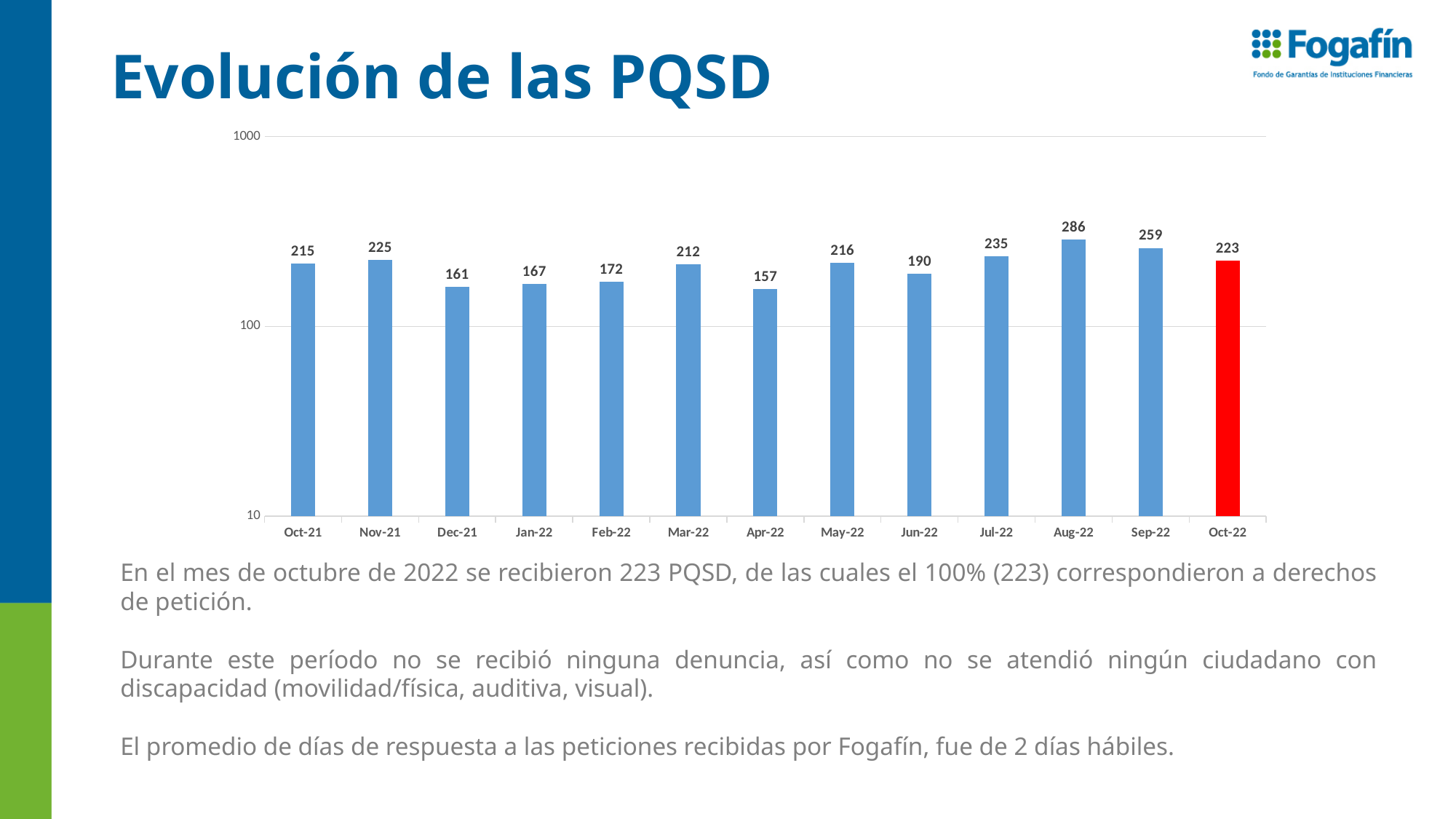
Is the value for Jun-22 greater or less than 100? greater What is the difference between the values for Aug-22 and Sep-22? 27 How many months are shown on the x axis? 13 Which month has the lowest value? Apr-22 What is the value for Aug-22? 286 Do the values rise or fall from Dec-21 to Mar-22? rise Which is larger, the value for Nov-21 or the value for Dec-21? Nov-21 What kind of chart is shown on the slide? bar chart What is the value for Apr-22? 157 Which month has the highest value? Aug-22 What is the value for Oct-22? 223 Which bar is coloured red instead of blue? Oct-22